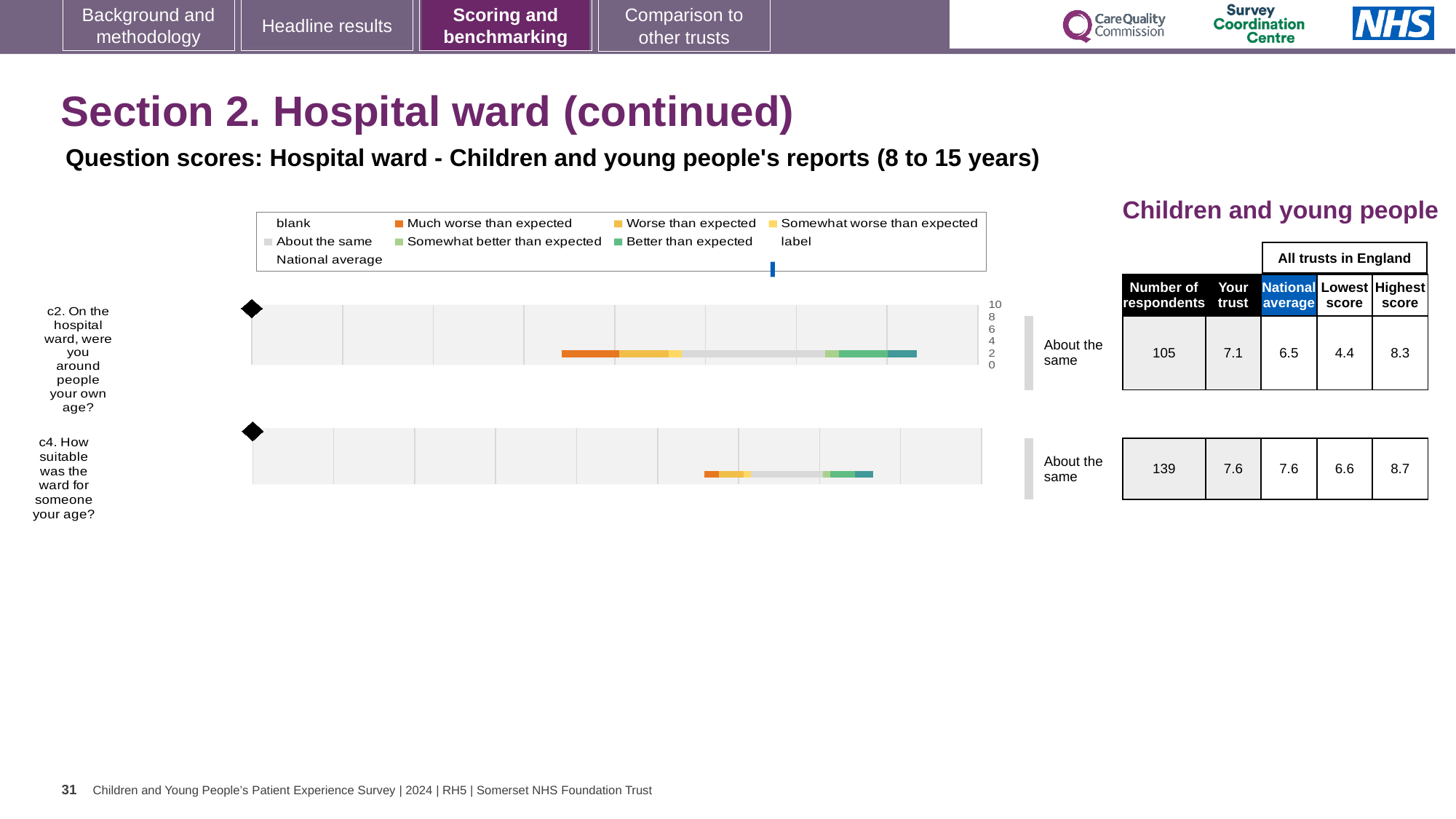
For question c4, what is the national average score? 7.6 How many questions are charted on the slide? 2 In the legend, what colour represents 'Much worse than expected'? orange What is the highest value shown on the vertical axis of the c2 chart? 10 Which question has the larger number of respondents, c2 or c4? c4 For question c2, which is larger: the 'Your trust' score or the national average? Your trust What kind of chart is used to show the question scores for c2 and c4? bar chart For question c2, what is the difference between the highest score and the lowest score among all trusts in England? 3.9 For question c2, what is the 'Your trust' score? 7.1 For question c4, what is the highest score among all trusts in England? 8.7 For question c2, what is the lowest score among all trusts in England? 4.4 For question c2, what is the number of respondents shown in the table? 105